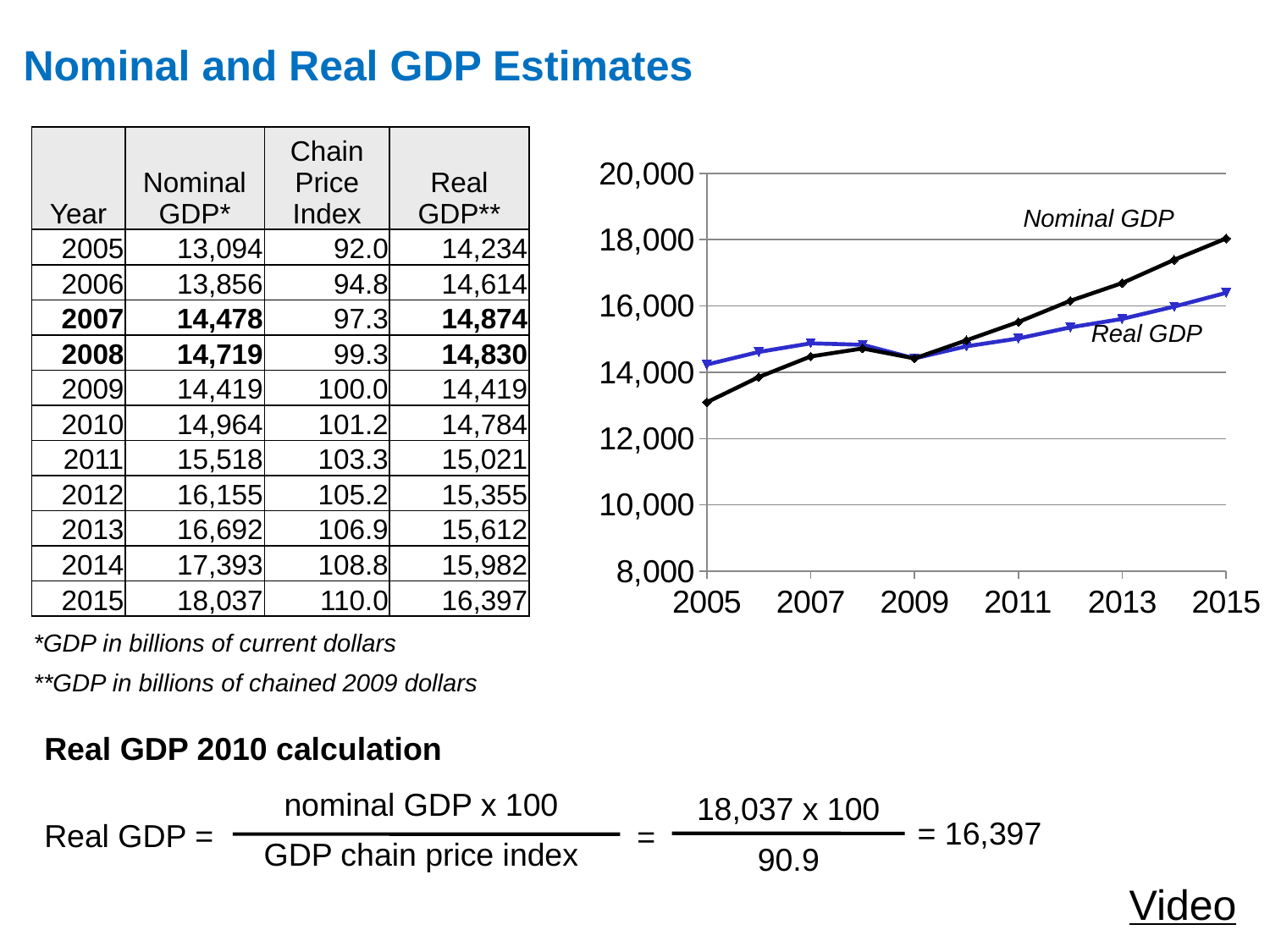
In which year is Nominal GDP highest? 2015 Is the Real GDP value for 2015 greater or less than 16,000? greater Is the Nominal GDP value for 2005 greater or less than 14,000? less In which year is Nominal GDP lowest? 2005 How many series are plotted on the chart? 2 What is the difference between Nominal GDP and Real GDP in 2015? 1,640 What is the Nominal GDP value for 2015? 18,037 Which is larger in 2005, Nominal GDP or Real GDP? Real GDP What kind of chart is shown on the slide? Line chart What is the Real GDP value for 2005? 14,234 How many years are plotted on the chart's x axis, from 2005 to 2015? 11 Which is larger in 2015, Nominal GDP or Real GDP? Nominal GDP